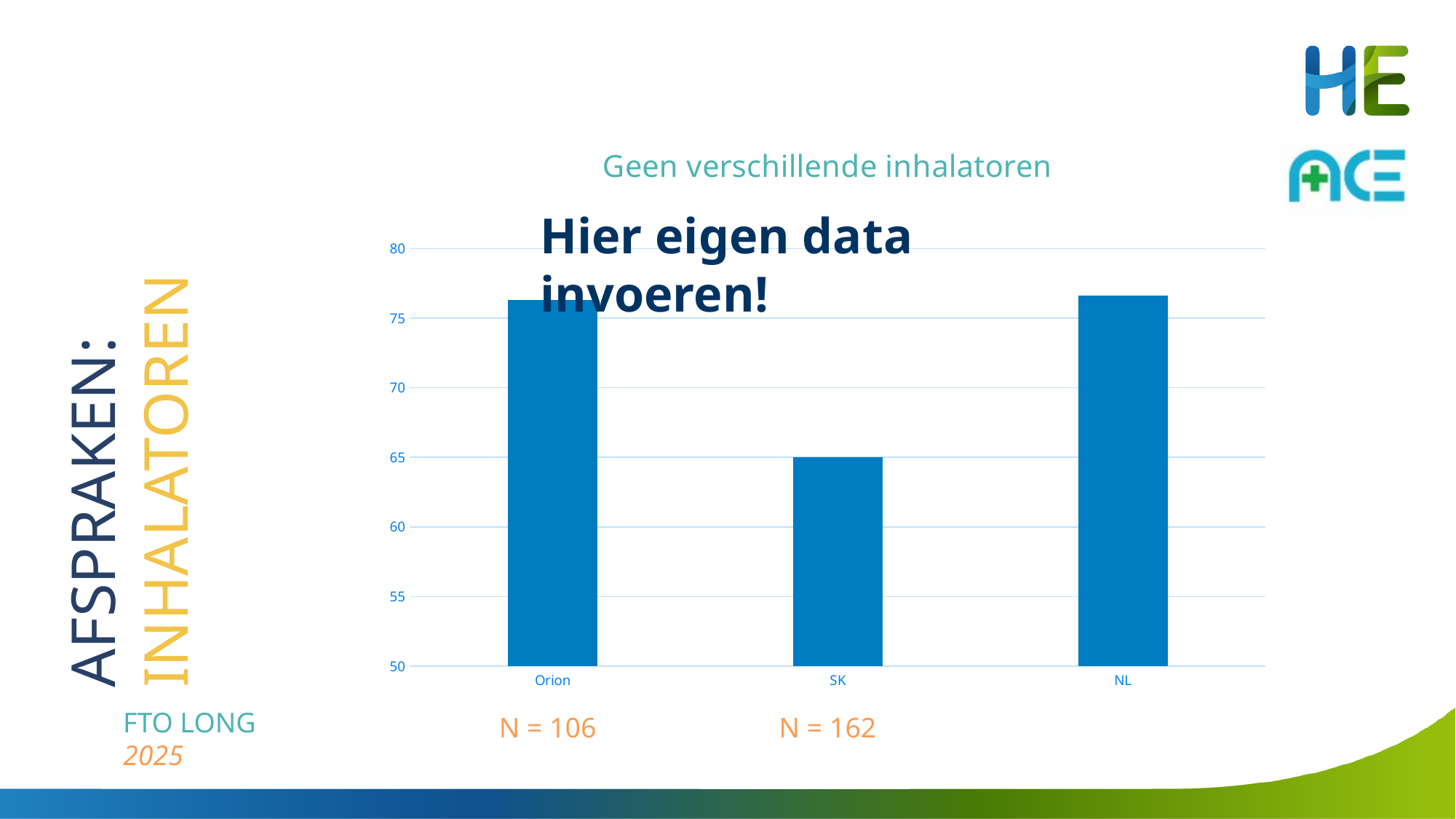
What is the value for SK in the chart? 65 Does the value rise or fall from Orion to SK? fall What is the title of the chart? Geen verschillende inhalatoren What kind of chart is shown on the slide? bar chart Is the value for NL greater or less than 75? greater Which is larger, the value for NL or the value for SK? NL How many categories are shown on the x axis of the chart? 3 Is the value for Orion greater or less than 80? less Is the value for Orion greater or less than 75? greater Which category has the lowest value in the chart? SK Which is larger, the value for Orion or the value for SK? Orion